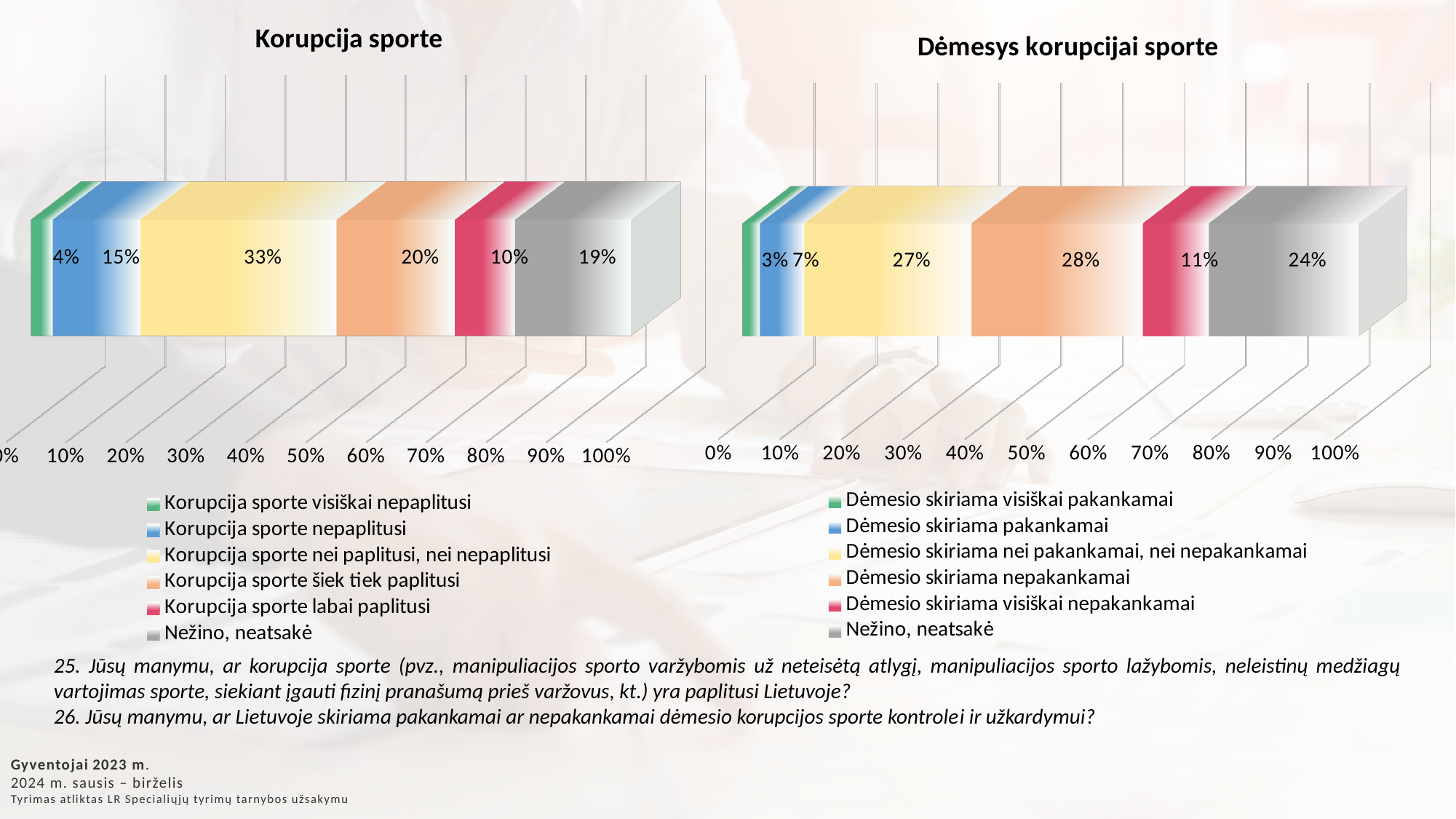
In the 'Dėmesys korupcijai sporte' chart, what is the combined share of 'Dėmesio skiriama nepakankamai' and 'Dėmesio skiriama visiškai nepakankamai'? 39% In the 'Dėmesys korupcijai sporte' chart, what percentage is shown for 'Dėmesio skiriama nepakankamai'? 28% In the 'Korupcija sporte' chart, which series has the largest share? Korupcija sporte nei paplitusi, nei nepaplitusi In the 'Dėmesys korupcijai sporte' chart, which is larger: 'Dėmesio skiriama pakankamai' or 'Dėmesio skiriama visiškai nepakankamai'? Dėmesio skiriama visiškai nepakankamai In the 'Korupcija sporte' chart, what is the difference between 'Korupcija sporte šiek tiek paplitusi' and 'Korupcija sporte nepaplitusi'? 5% What colour represents 'Nežino, neatsakė' in both charts? Grey How many series does the legend of the 'Korupcija sporte' chart list? 6 In the 'Korupcija sporte' chart, what percentage is shown for 'Korupcija sporte nei paplitusi, nei nepaplitusi'? 33% In the 'Korupcija sporte' chart, what percentage is shown for 'Korupcija sporte labai paplitusi'? 10% What kind of chart is the 'Dėmesys korupcijai sporte' chart? Stacked bar chart In the 'Dėmesys korupcijai sporte' chart, which series has the smallest share? Dėmesio skiriama visiškai pakankamai In the 'Dėmesys korupcijai sporte' chart, what percentage is shown for 'Nežino, neatsakė'? 24%